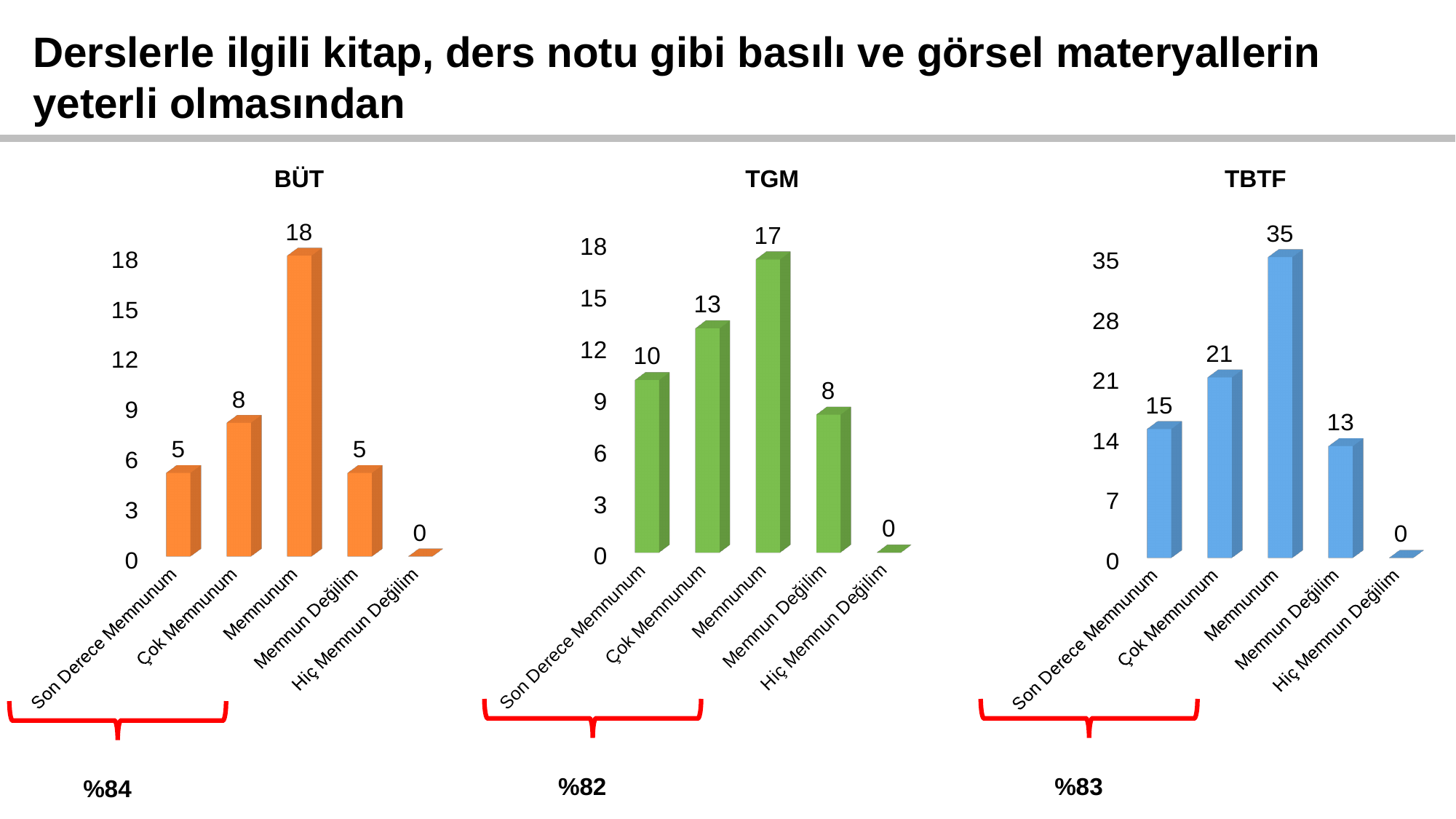
In the TBTF chart, which category has the highest value? Memnunum In the TGM chart, which category has the lowest value? Hiç Memnun Değilim In the TGM chart, what is the value for Çok Memnunum? 13 In the TGM chart, which is larger, the value for Son Derece Memnunum or the value for Memnun Değilim? Son Derece Memnunum In the BÜT chart, how many categories are shown on the x axis? 5 What kind of chart is the TGM chart? bar chart In the BÜT chart, what is the value for Memnunum? 18 In the BÜT chart, what is the difference between the values for Memnunum and Çok Memnunum? 10 In the TBTF chart, what is the value for Memnun Değilim? 13 What percentage is shown below the bracket under the TBTF chart? %83 In the TBTF chart, what is the difference between the values for Memnunum and Çok Memnunum? 14 How many charts are shown on the slide? 3